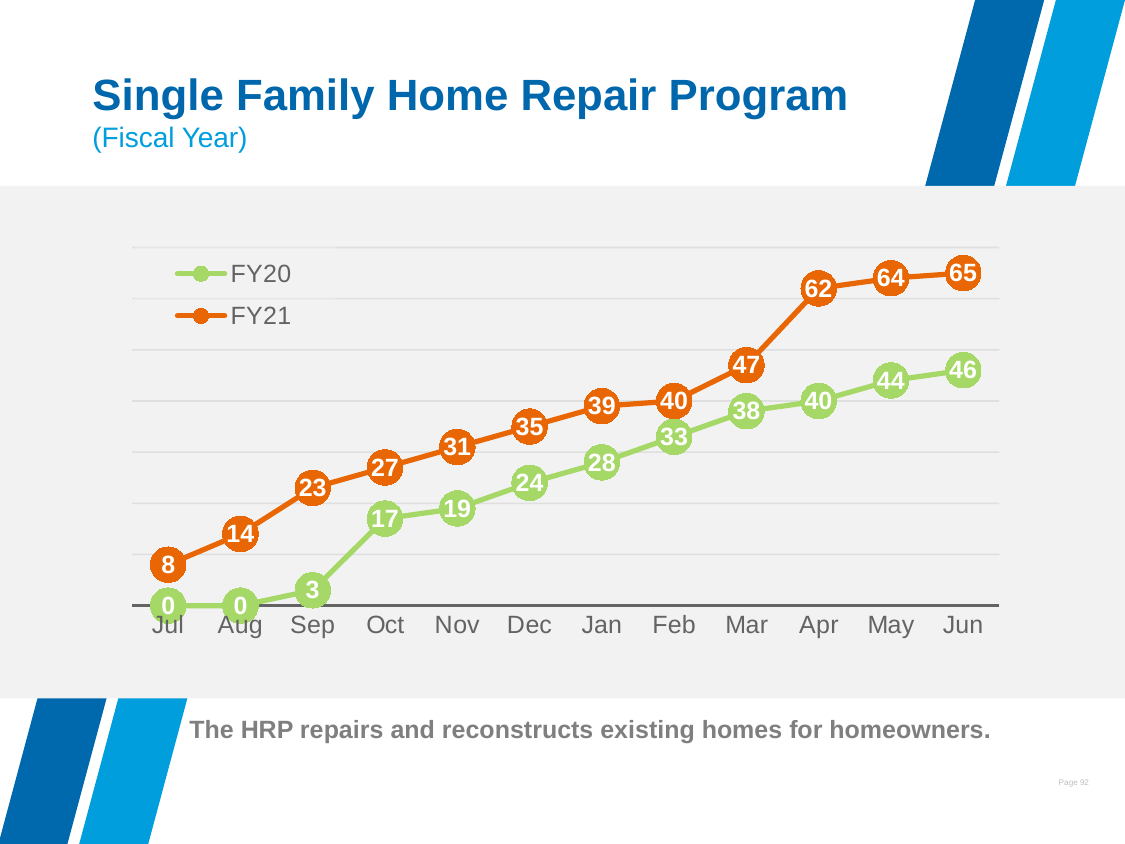
Do the FY21 values rise or fall from Jul to Jun? Rise What kind of chart is shown on the slide? Line chart What is the difference between the FY21 values for Apr and Mar? 15 What is the FY20 value for Oct? 17 Which month has the lowest FY21 value? Jul How many months are plotted on the x axis? 12 How many series does the legend list? 2 Which month has the highest FY20 value? Jun Which is larger, the FY20 value for Feb or the FY21 value for Nov? FY20 value for Feb What is the difference between the FY21 and FY20 values for Jun? 19 What is the FY21 value for Jun? 65 What is the FY21 value for Mar? 47